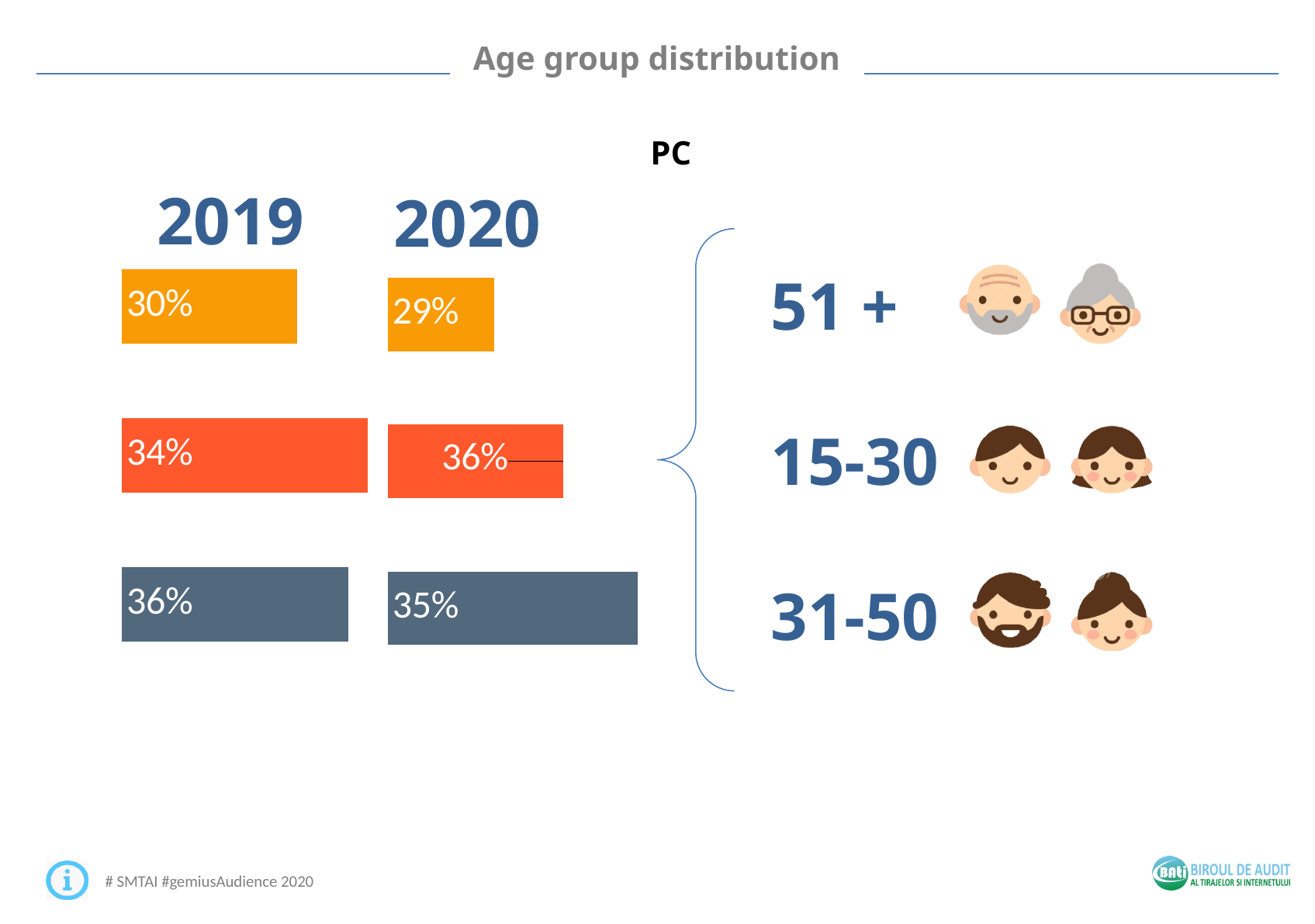
How many years are compared in the chart? 2 How many age groups are shown in the chart? 3 What is the difference between the 2019 and 2020 values for the 15-30 age group? 2% Which age group has the lowest share in 2020? 51 + What kind of chart is shown on the slide? Bar chart Which device does the chart refer to, according to the label above it? PC What is the 2019 value for the 51+ age group? 30% Which is larger, the 2019 value for 31-50 or the 2020 value for 31-50? 2019 (36%) What is the 2020 value for the 31-50 age group? 35% What is the 2020 value for the 15-30 age group? 36% What is the 2019 value for the 15-30 age group? 34% Which age group has the highest share in 2019? 31-50